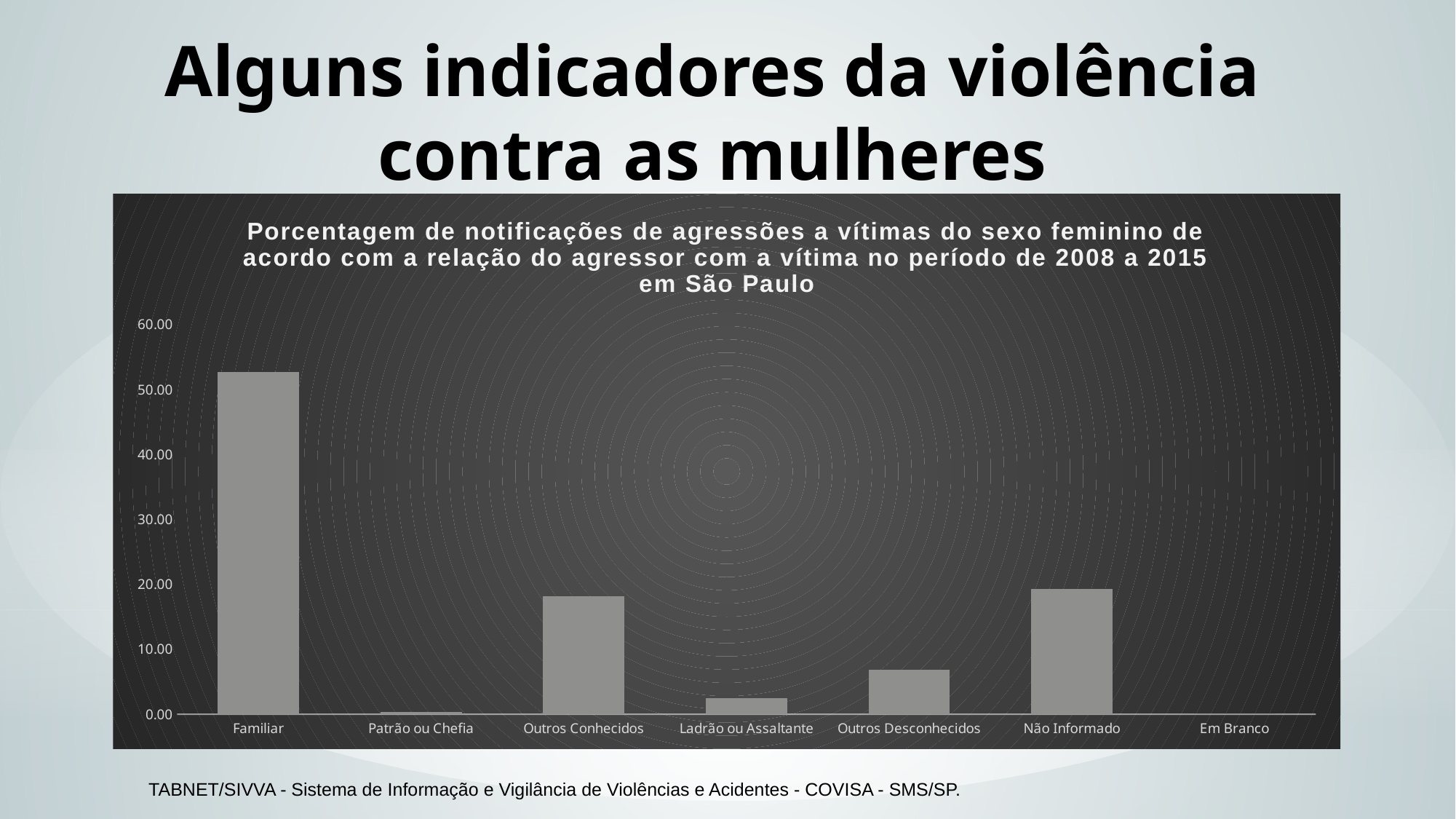
Which category has the highest value in the chart? Familiar What kind of chart is shown on the slide? bar chart Is the value for Ladrão ou Assaltante greater or less than 10? less Is the value for Não Informado greater or less than 10? greater Is the value for Familiar greater or less than 50? greater What period does the chart title say the data covers? 2008 a 2015 How many categories are shown on the x axis of the chart? 7 Which is larger, the value for Familiar or the value for Não Informado? Familiar Which is larger, the value for Outros Desconhecidos or the value for Ladrão ou Assaltante? Outros Desconhecidos